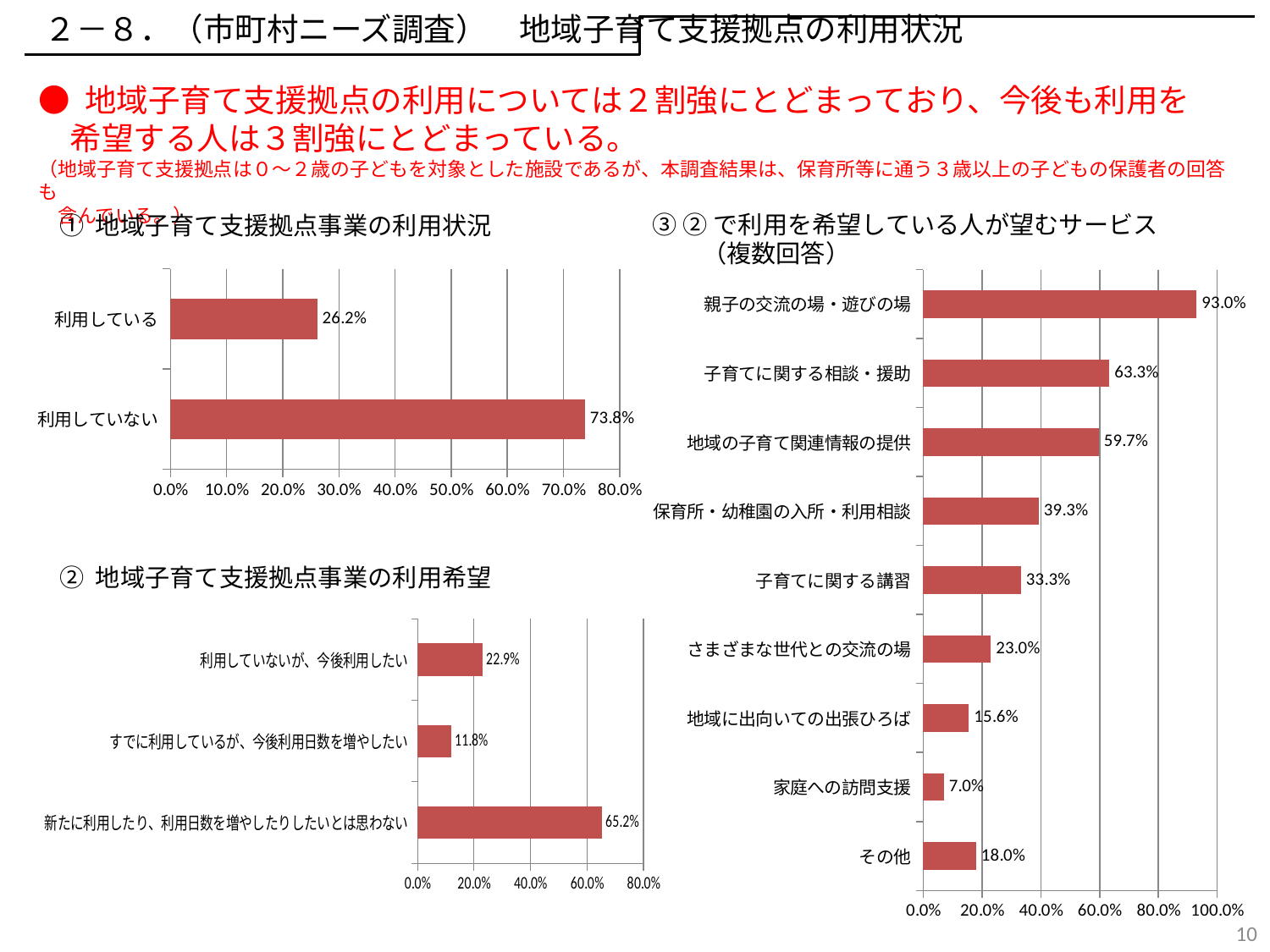
In the chart ③ ②で利用を希望している人が望むサービス（複数回答）, what is the difference between 子育てに関する相談・援助 and 地域の子育て関連情報の提供? 3.6% In the chart ③ ②で利用を希望している人が望むサービス（複数回答）, which category has the lowest value? 家庭への訪問支援 In the chart ③ ②で利用を希望している人が望むサービス（複数回答）, how many categories are shown? 9 In the chart ① 地域子育て支援拠点事業の利用状況, what is the difference between 利用していない and 利用している? 47.6% In the chart ② 地域子育て支援拠点事業の利用希望, which category has the highest value? 新たに利用したり、利用日数を増やしたりしたいとは思わない In the chart ② 地域子育て支援拠点事業の利用希望, what is the value for すでに利用しているが、今後利用日数を増やしたい? 11.8% In the chart ③ ②で利用を希望している人が望むサービス（複数回答）, what is the value for 親子の交流の場・遊びの場? 93.0% In the chart ③ ②で利用を希望している人が望むサービス（複数回答）, which is larger: 子育てに関する講習 or さまざまな世代との交流の場? 子育てに関する講習 In the chart ② 地域子育て支援拠点事業の利用希望, how many categories are shown? 3 In the chart ③ ②で利用を希望している人が望むサービス（複数回答）, is the value for 保育所・幼稚園の入所・利用相談 greater or less than 40.0%? less What kind of chart is the chart ① 地域子育て支援拠点事業の利用状況? bar chart In the chart ① 地域子育て支援拠点事業の利用状況, what is the value for 利用している? 26.2%